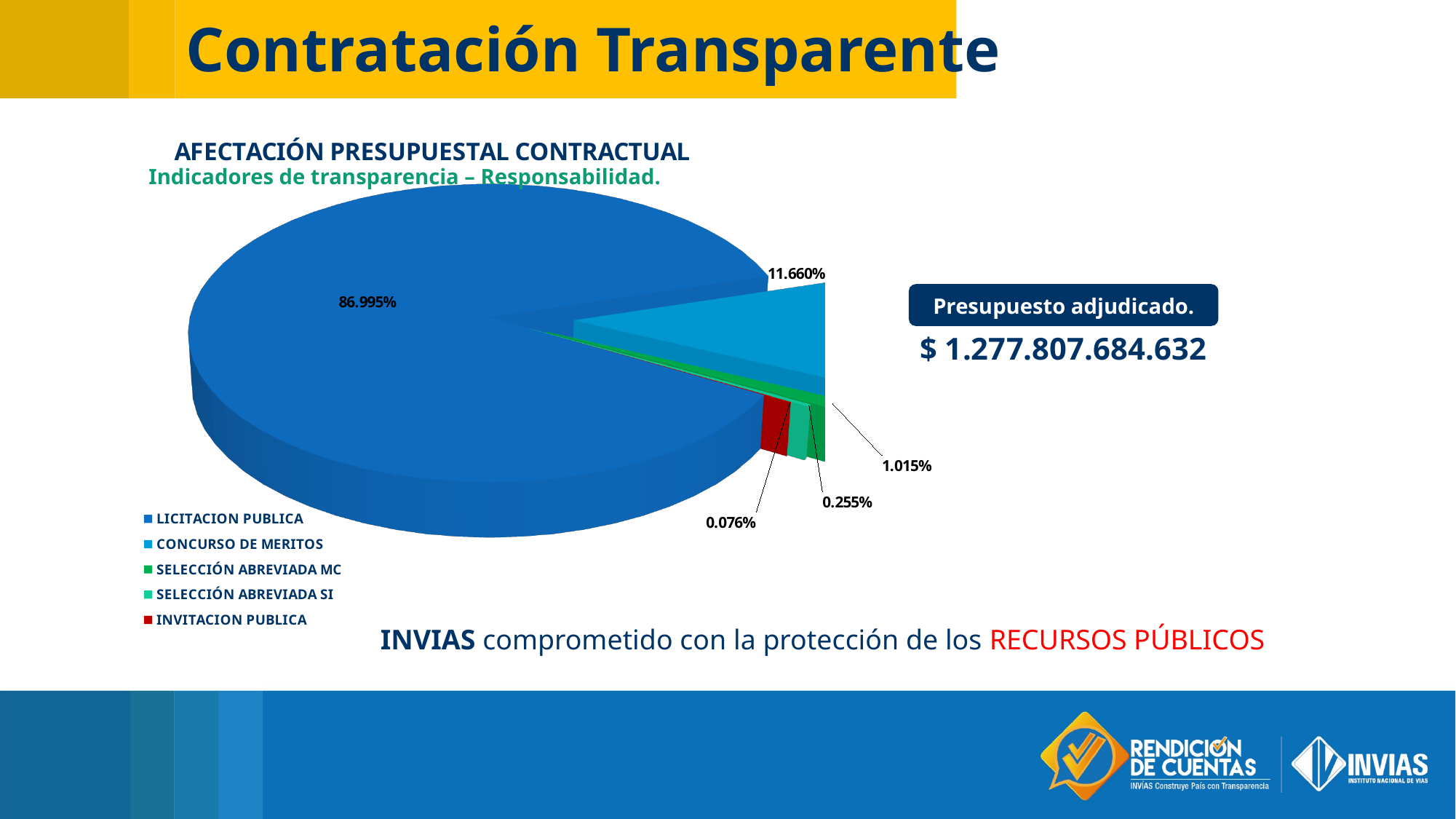
What share of the pie does SELECCIÓN ABREVIADA MC represent? 1.015% What share of the pie does LICITACION PUBLICA represent? 86.995% Which is larger, the share for CONCURSO DE MERITOS or the share for SELECCIÓN ABREVIADA MC? CONCURSO DE MERITOS What is the difference in percentage points between the LICITACION PUBLICA share and the CONCURSO DE MERITOS share? 75.335% What is the title of the chart? AFECTACIÓN PRESUPUESTAL CONTRACTUAL Which category has the largest slice of the pie? LICITACION PUBLICA What share of the pie does CONCURSO DE MERITOS represent? 11.660% What kind of chart is shown on the slide? Pie chart Which category has the smallest slice of the pie? INVITACION PUBLICA How many categories does the legend of the pie chart list? 5